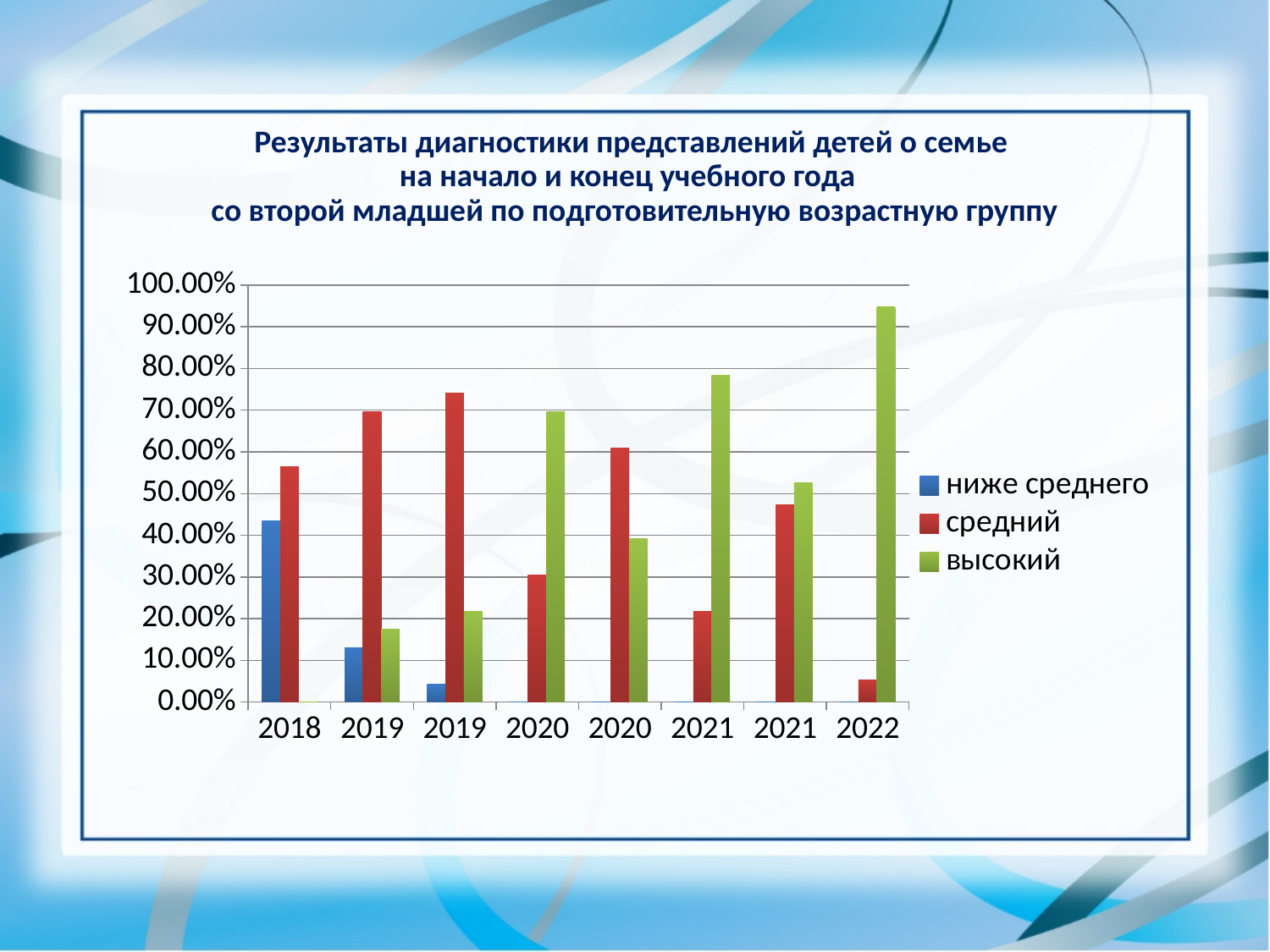
How many series does the legend list? 3 Which category has the highest value for the series "ниже среднего"? 2018 Is the value for "высокий" in 2022 greater or less than 90.00%? greater Which category has the highest value for the series "высокий"? 2022 Which category has the lowest value for the series "средний"? 2022 How many category labels are shown along the x axis? 8 What kind of chart is shown on the slide? bar chart Is the value for "средний" in 2022 greater or less than 10.00%? less In 2018, which is larger: the value for "средний" or the value for "ниже среднего"? средний Do the values for the series "высокий" generally rise or fall from left to right along the x axis? rise Is the value for "средний" in 2018 greater or less than 50.00%? greater Which colour represents the series "высокий" in the legend? green